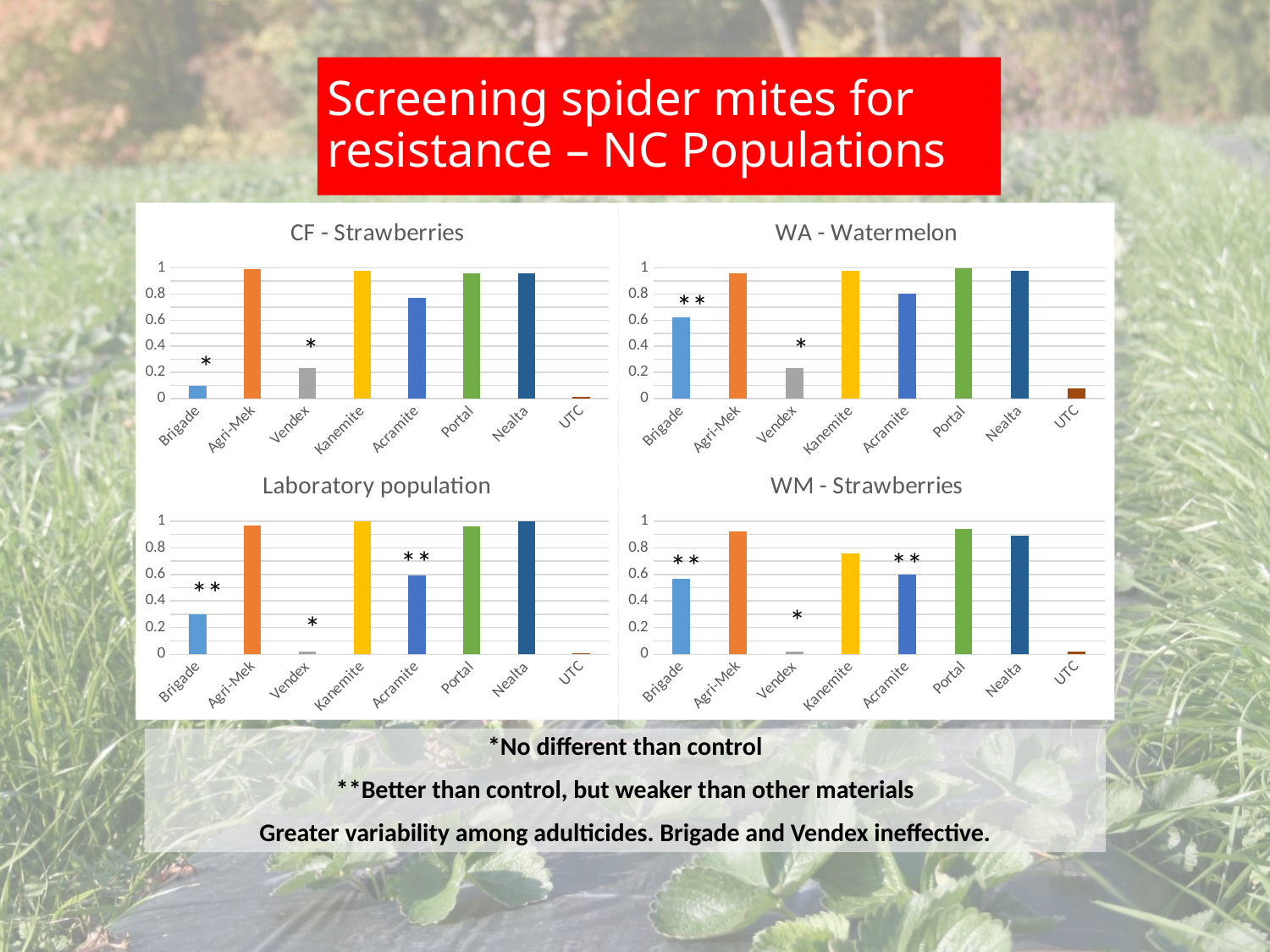
How many charts are shown on the slide? 4 In the CF - Strawberries chart, is the value for Acramite greater or less than 0.6? greater In the CF - Strawberries chart, is the value for Vendex greater or less than 0.4? less In the Laboratory population chart, which is larger, the value for Brigade or the value for Acramite? Acramite In the WA - Watermelon chart, which is larger, the value for Brigade or the value for Vendex? Brigade How many categories are shown on the x axis of the WA - Watermelon chart? 8 In the WM - Strawberries chart, is the value for Kanemite greater or less than 0.8? less What kind of chart is the CF - Strawberries chart? bar chart In the CF - Strawberries chart, which category has the lowest value? UTC In the WM - Strawberries chart, which is larger, the value for Kanemite or the value for Acramite? Kanemite